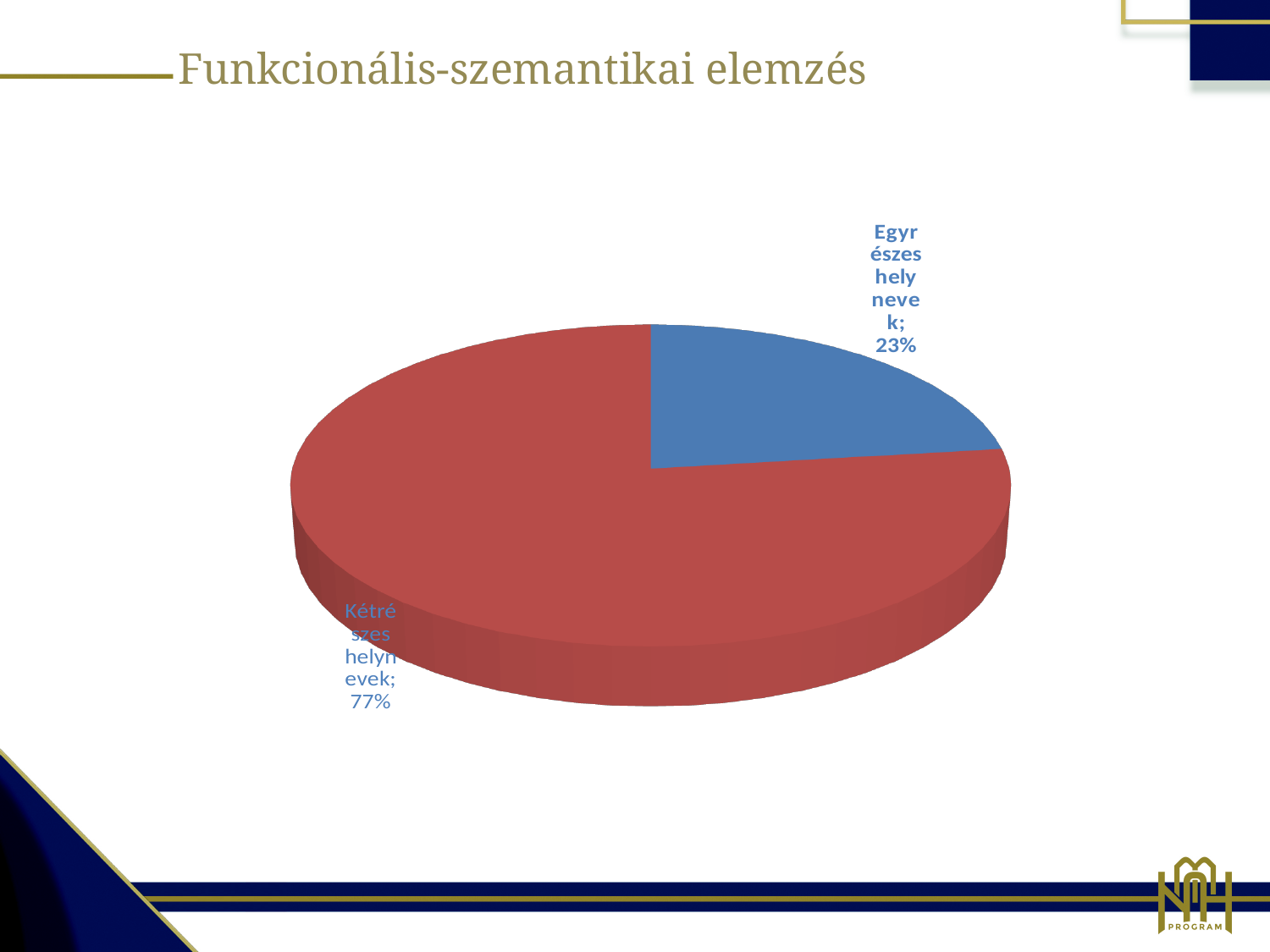
What is the difference in percentage points between the Kétrészes helynevek slice and the Egyrészes helynevek slice? 54 What share of the pie is labelled Kétrészes helynevek? 77% What share of the pie is labelled Egyrészes helynevek? 23% Which slice of the pie is the smallest? Egyrészes helynevek Which is larger, the Egyrészes helynevek slice or the Kétrészes helynevek slice? Kétrészes helynevek Which slice of the pie is the largest? Kétrészes helynevek How many slices does the pie chart have? 2 What kind of chart is shown on the slide? pie chart What colour is the Egyrészes helynevek slice? blue What is the title of the slide containing the pie chart? Funkcionális-szemantikai elemzés